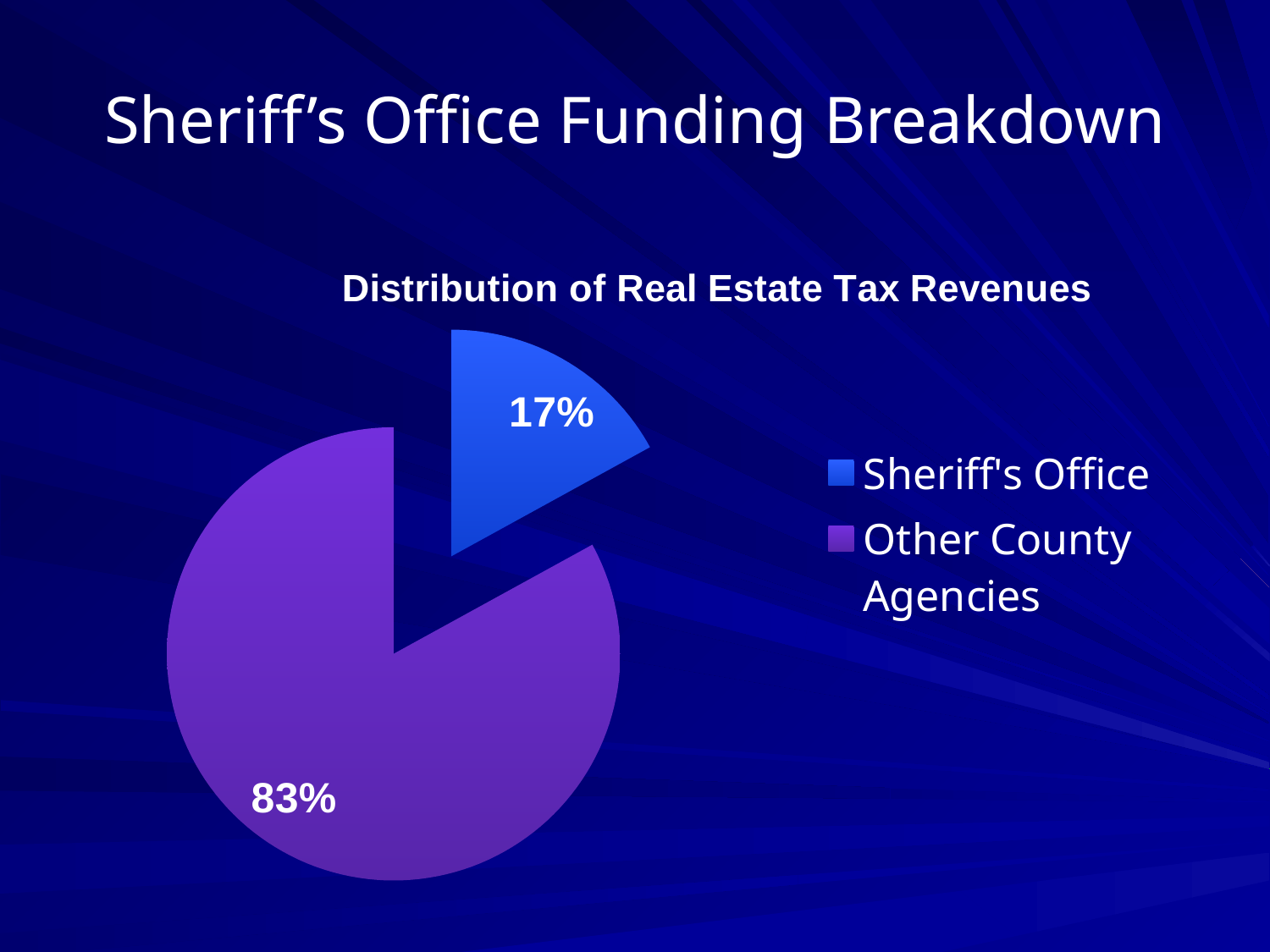
What kind of chart is shown on the slide? pie chart What share of real estate tax revenues goes to the Sheriff's Office? 17% Which legend entry is shown in blue? Sheriff's Office What is the difference in percentage points between the Other County Agencies slice and the Sheriff's Office slice? 66 Which category has the smallest slice of the pie? Sheriff's Office Which category has the largest slice of the pie? Other County Agencies How many slices does the pie chart have? 2 Which is larger, the Sheriff's Office slice or the Other County Agencies slice? Other County Agencies What is the chart's title? Distribution of Real Estate Tax Revenues What share of real estate tax revenues goes to Other County Agencies? 83% How many entries does the legend list? 2